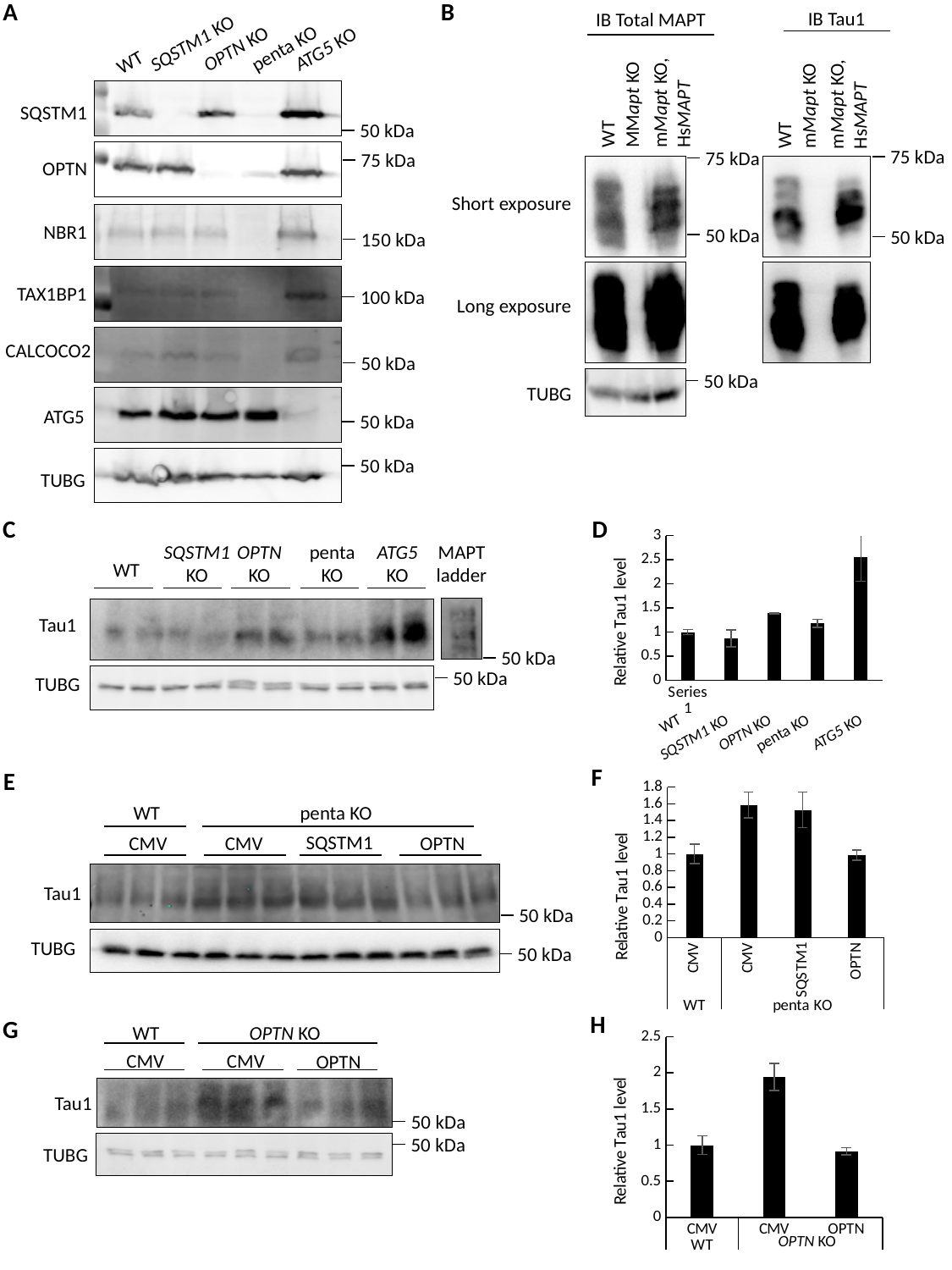
In chart H (bottom right), which category has the highest relative Tau1 level? CMV in OPTN KO In chart H (bottom right), which is larger, the value for CMV in OPTN KO or the value for OPTN in OPTN KO? CMV in OPTN KO In chart F (middle right), is the value for OPTN in penta KO greater or less than 1.2? less In chart F (middle right), is the value for CMV in penta KO greater or less than 1.4? greater In chart D (top right), which is larger, the value for ATG5 KO or the value for WT? ATG5 KO In chart F (middle right), how many bars are plotted? 4 In chart D (top right), how many categories are plotted on the x axis? 5 In chart D (top right), is the value for OPTN KO greater or less than 1? greater What kind of chart is chart H (bottom right)? bar chart In chart D (top right), which category has the highest relative Tau1 level? ATG5 KO